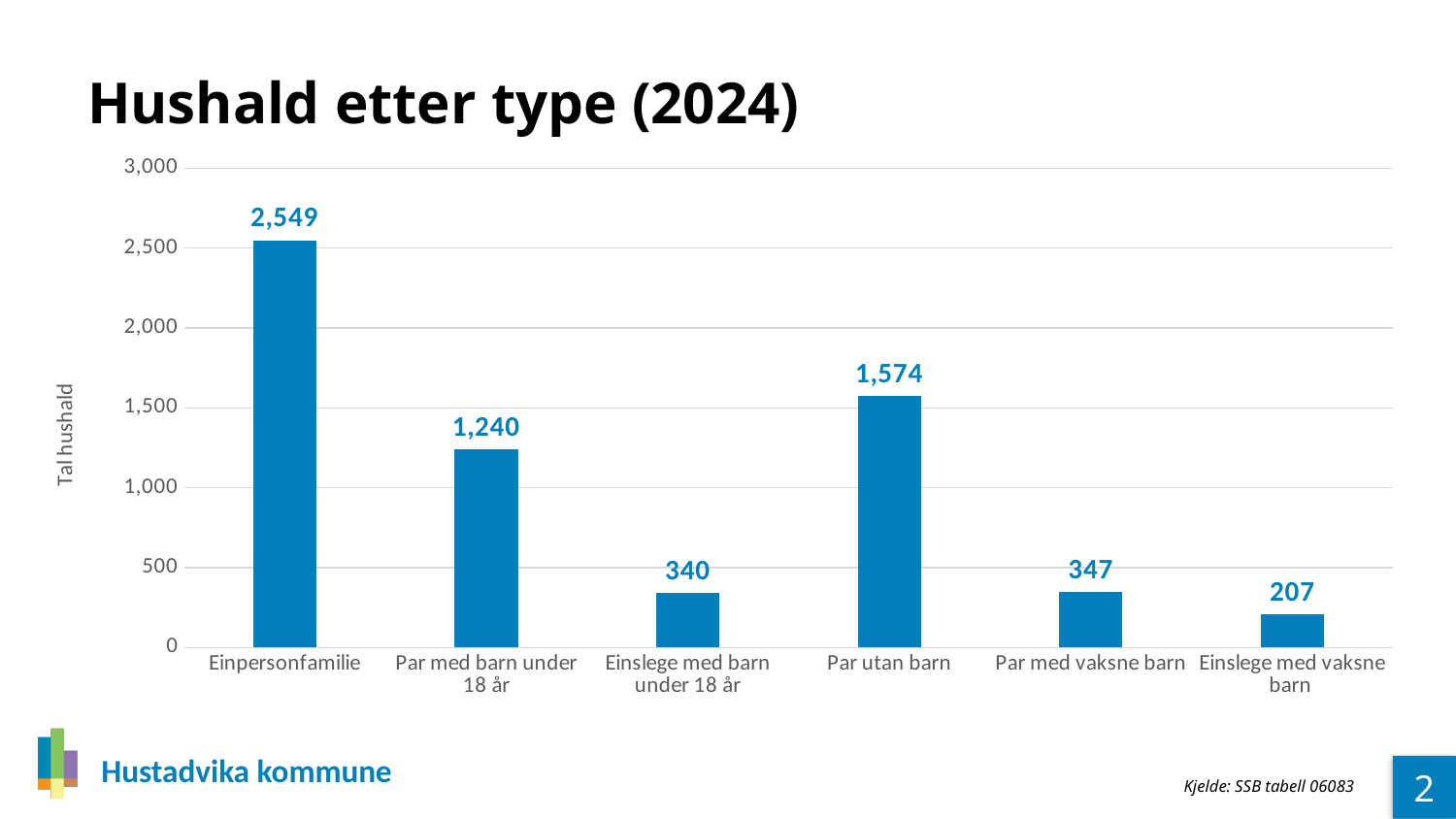
Which household type has the highest value? Einpersonfamilie Is the value for Par med barn under 18 år greater or less than 1,000? greater How many household types are shown in the chart? 6 Which is larger, Par med barn under 18 år or Par utan barn? Par utan barn What is the value for Par utan barn? 1,574 What is the value for Einslege med vaksne barn? 207 What is the value for Einpersonfamilie? 2,549 Which household type has the lowest value? Einslege med vaksne barn What is the title of the chart? Hushald etter type (2024) What is the difference between Par med vaksne barn and Einslege med barn under 18 år? 7 What is the difference between Einpersonfamilie and Par utan barn? 975 What kind of chart is shown on the slide? Bar chart